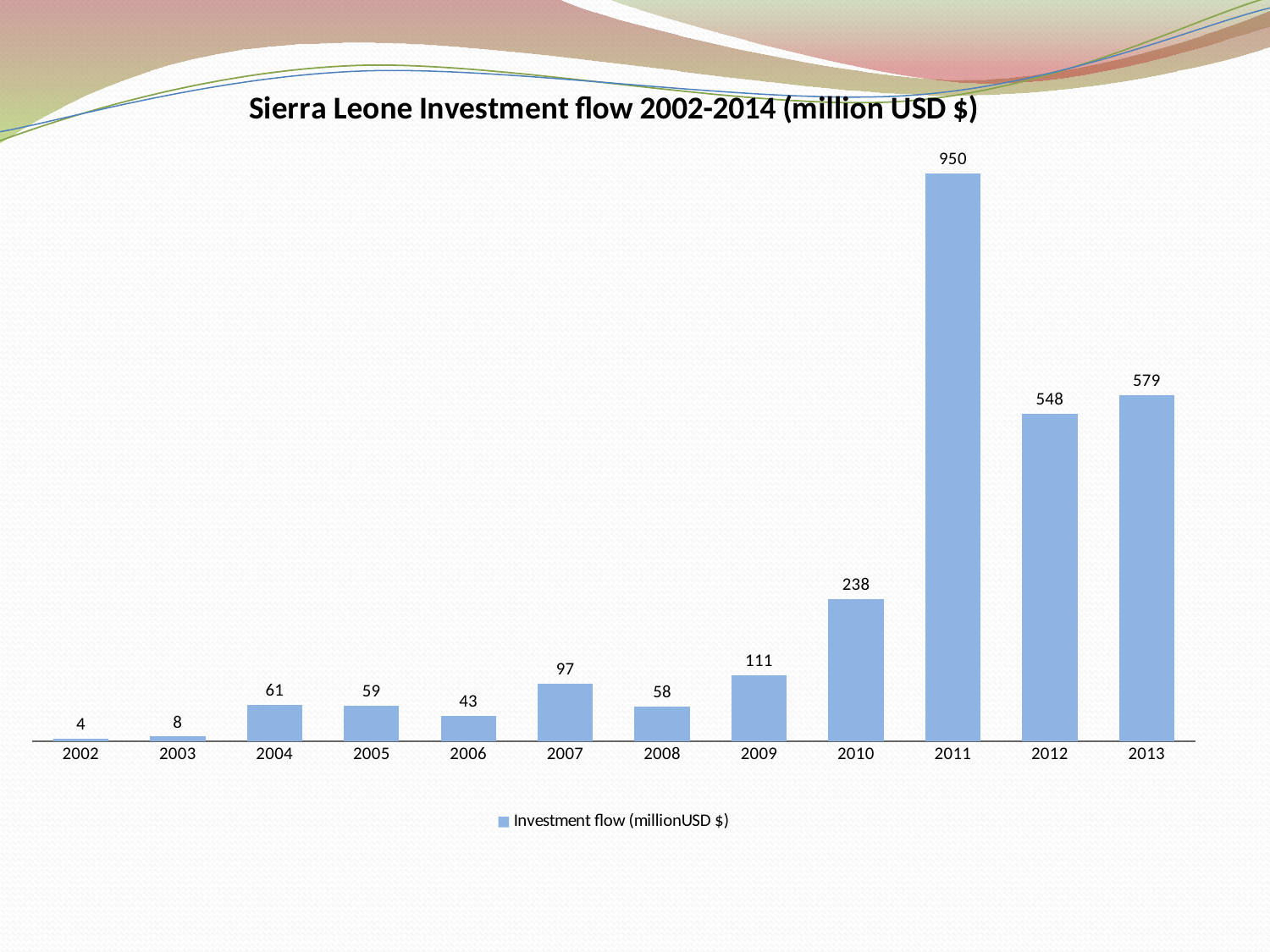
Which year has a larger investment flow, 2004 or 2005? 2004 Which year has the lowest investment flow? 2002 What is the investment flow value for 2006? 43 What is the investment flow value for 2011? 950 What is the title of the chart? Sierra Leone Investment flow 2002-2014 (million USD $) Which year has the highest investment flow? 2011 What kind of chart is shown on the slide? Bar chart Which year has a larger investment flow, 2013 or 2012? 2013 What is the difference between the investment flow in 2011 and in 2012? 402 What is the difference between the investment flow in 2010 and in 2009? 127 What is the investment flow value for 2013? 579 How many years are shown on the x axis of the chart? 12